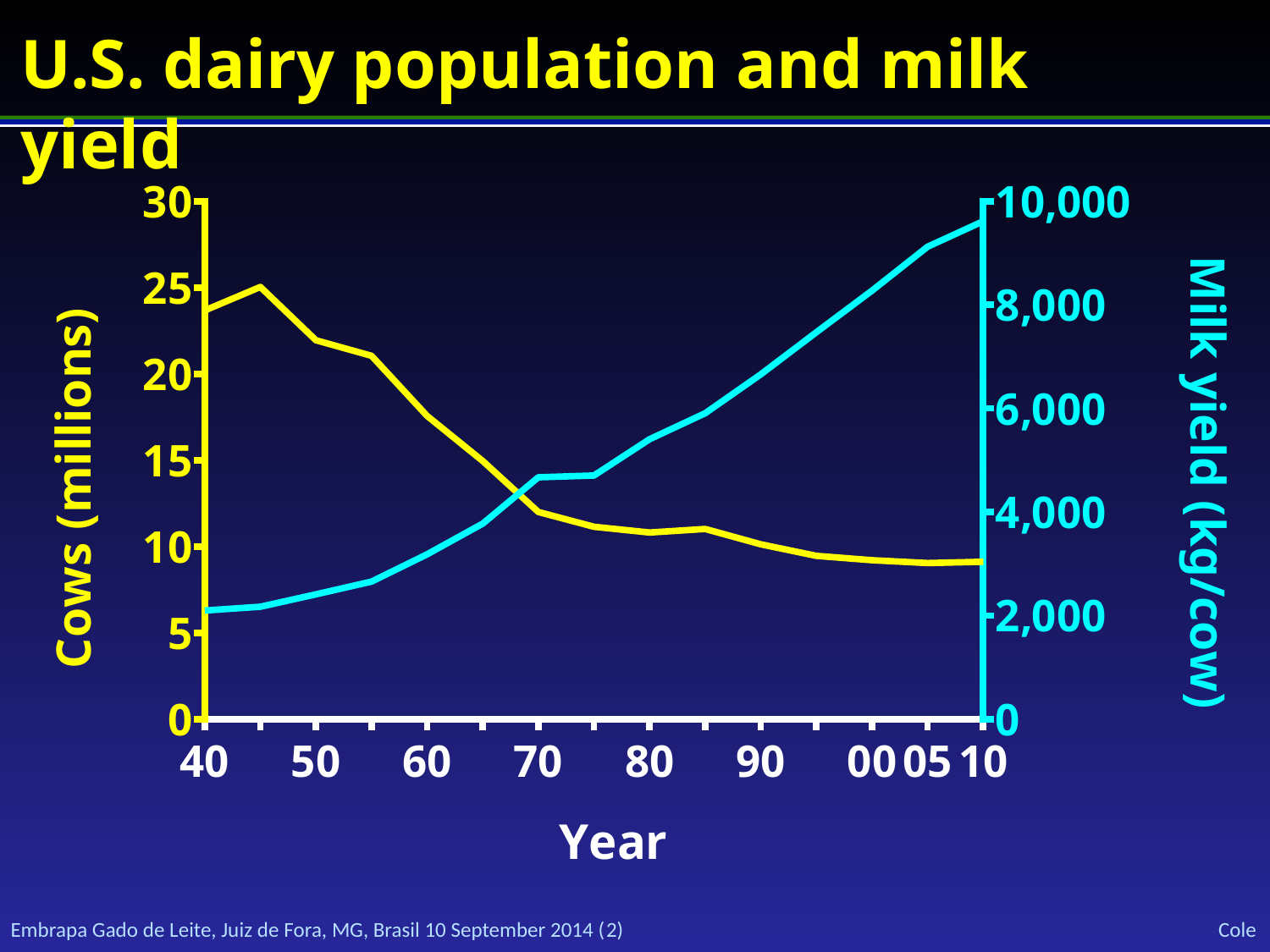
Is the value for Milk yield (kg/cow) at year 60 greater or less than 4,000? less Is the value for Milk yield (kg/cow) at year 10 greater or less than 8,000? greater Which year has the lowest value for Milk yield (kg/cow)? 40 Which year has the highest value for Milk yield (kg/cow)? 10 What is the label of the right-hand vertical axis? Milk yield (kg/cow) Does the Milk yield (kg/cow) line rise or fall overall from 40 to 10 along the x axis? rise What kind of chart is shown on the slide? line chart Is the value for Cows (millions) at year 40 greater or less than 20? greater Does the Cows (millions) line rise or fall overall from 40 to 10 along the x axis? fall What is the title of the chart? U.S. dairy population and milk yield Is the value for Cows (millions) larger at year 50 or at year 90? 50